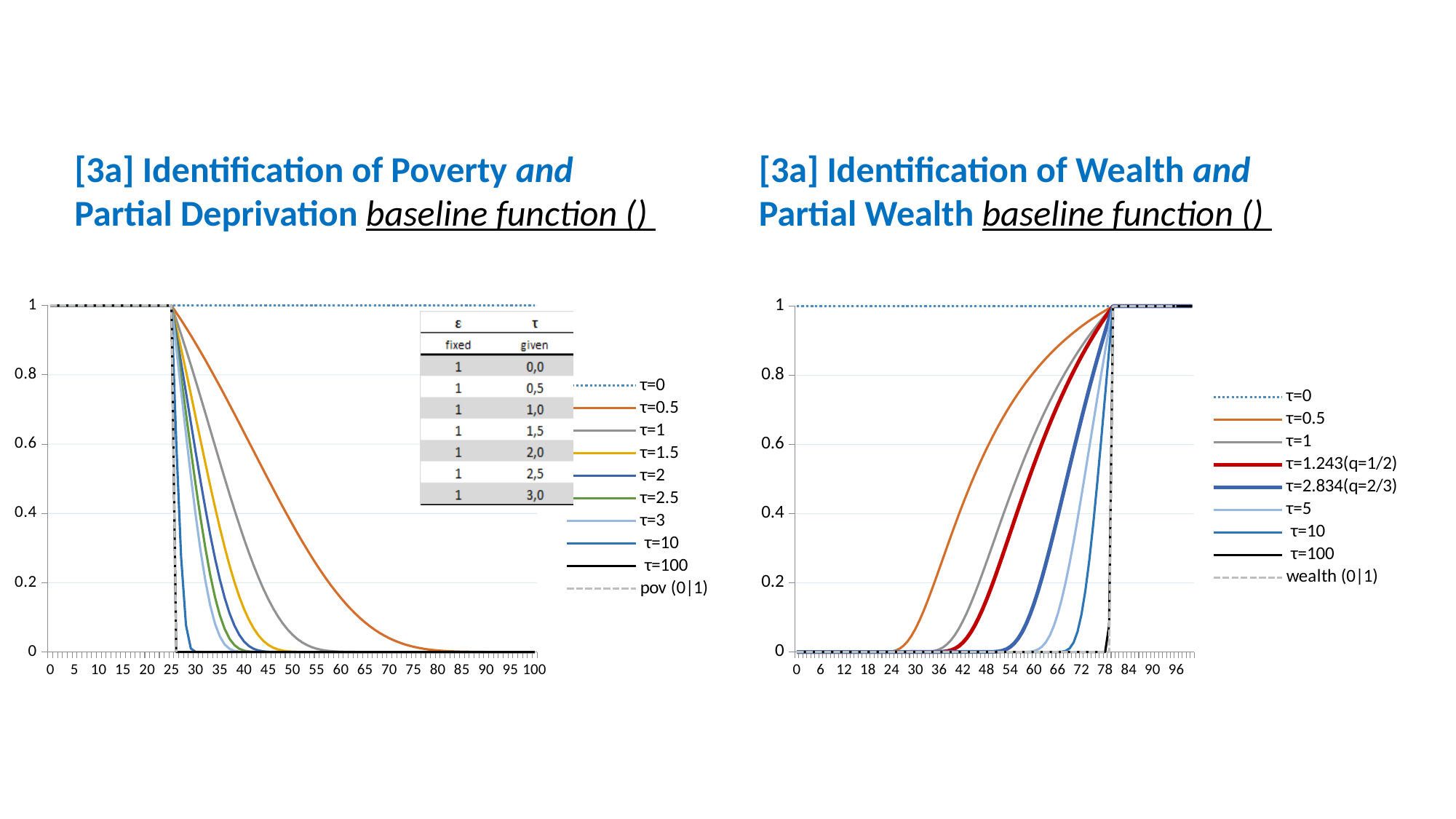
How many series does the legend of the left chart (Poverty and Partial Deprivation) list? 10 In the right chart (Wealth and Partial Wealth), which legend entry is drawn as a thick red line? τ=1.243(q=1/2) How many series does the legend of the right chart (Wealth and Partial Wealth) list? 9 In the left chart (Poverty and Partial Deprivation), do the τ=0.5 to τ=100 curves rise or fall as x increases beyond 25? Fall In the right chart (Wealth and Partial Wealth), is the value of the τ=1 curve at x=42 greater or less than 0.4? less What kind of chart is the right chart, 'Identification of Wealth and Partial Wealth baseline function'? Line chart In the left chart (Poverty and Partial Deprivation), is the value of the τ=0.5 curve at x=70 greater or less than 0.2? less What kind of chart is the left chart, 'Identification of Poverty and Partial Deprivation baseline function'? Line chart In the right chart (Wealth and Partial Wealth), do the τ=0.5 to τ=100 curves rise or fall as x increases toward 78? Rise What is the last legend entry of the left chart (Poverty and Partial Deprivation)? pov (0|1) In the left chart (Poverty and Partial Deprivation), is the value of the τ=0.5 curve at x=40 greater or less than 0.6? greater